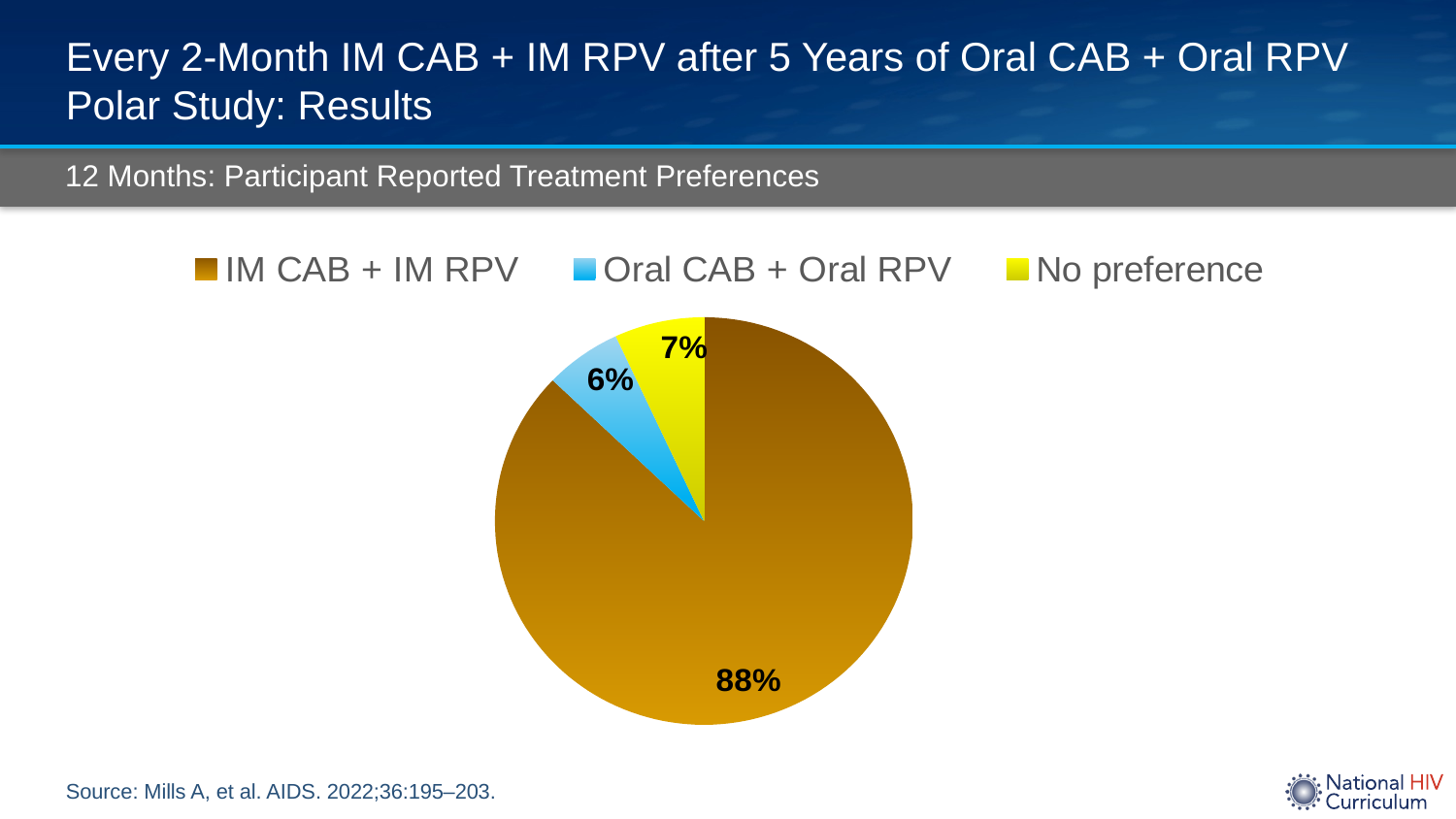
What percentage of participants reported no preference? 7% What is the difference in percentage points between the IM CAB + IM RPV share and the Oral CAB + Oral RPV share? 82 percentage points What is the subtitle describing the data shown in the chart? 12 Months: Participant Reported Treatment Preferences How many entries does the legend list? 3 Which is larger: the share for No preference or the share for Oral CAB + Oral RPV? No preference How many categories are shown in the pie chart? 3 Which treatment preference category has the largest share of the pie? IM CAB + IM RPV What colour represents the No preference category in the pie chart? Yellow What percentage of participants preferred IM CAB + IM RPV? 88% What percentage of participants preferred Oral CAB + Oral RPV? 6% What type of chart is shown on the slide? Pie chart Which category has the smallest share of the pie? Oral CAB + Oral RPV